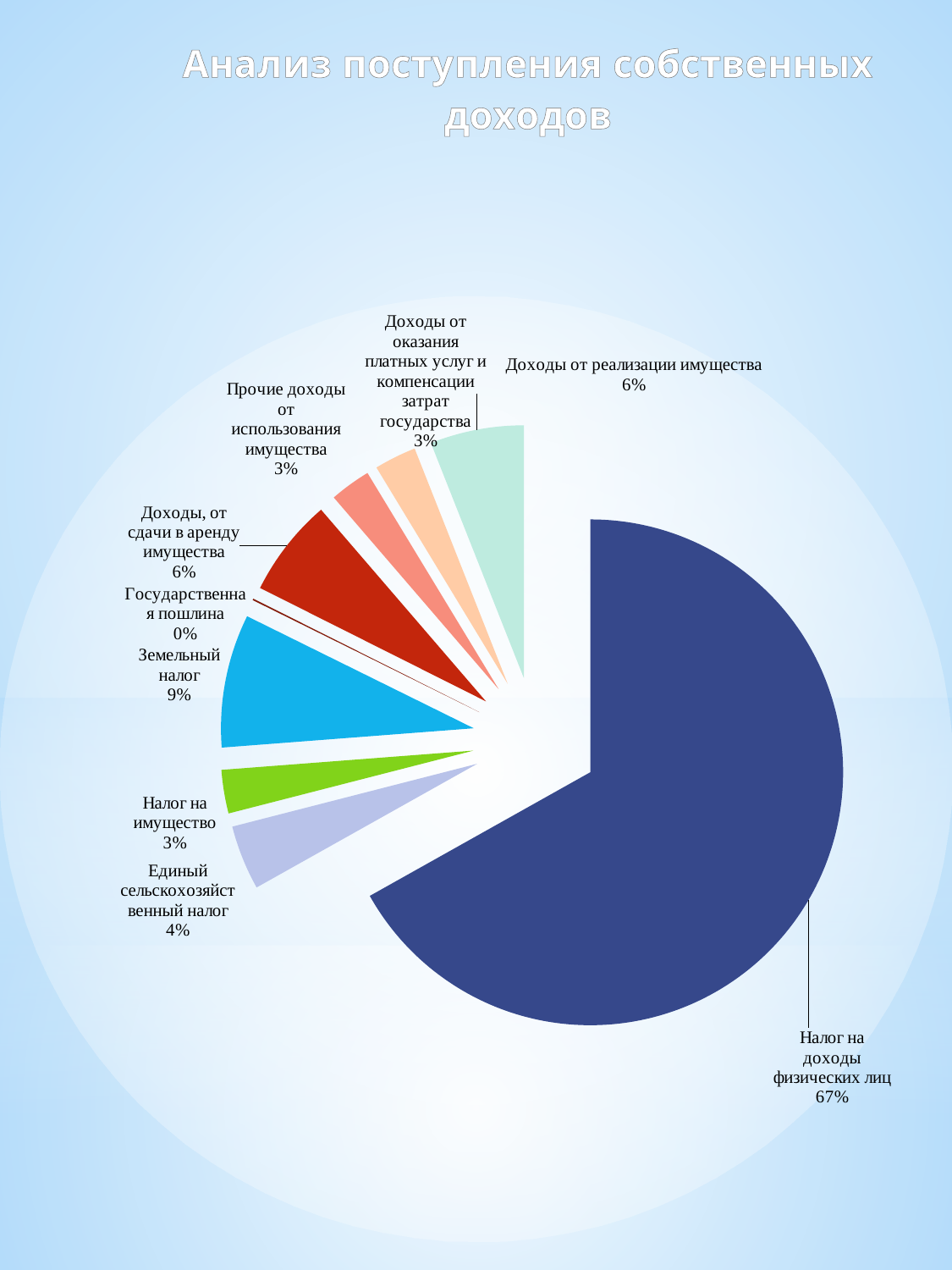
What is the value shown for "Земельный налог"? 9% What share of the pie does "Налог на доходы физических лиц" have? 67% Which category has the largest slice of the pie? Налог на доходы физических лиц Which category has the smallest slice of the pie? Государственная пошлина What is the value shown for "Доходы от реализации имущества"? 6% What is the difference between the shares of "Налог на доходы физических лиц" and "Земельный налог"? 58% What kind of chart is shown on the slide? pie chart What is the value shown for "Государственная пошлина"? 0% How many slices does the pie chart have? 9 What is the title of the chart on the slide? Анализ поступления собственных доходов Which is larger: the share of "Земельный налог" or the share of "Налог на имущество"? Земельный налог What is the value shown for "Единый сельскохозяйственный налог"? 4%